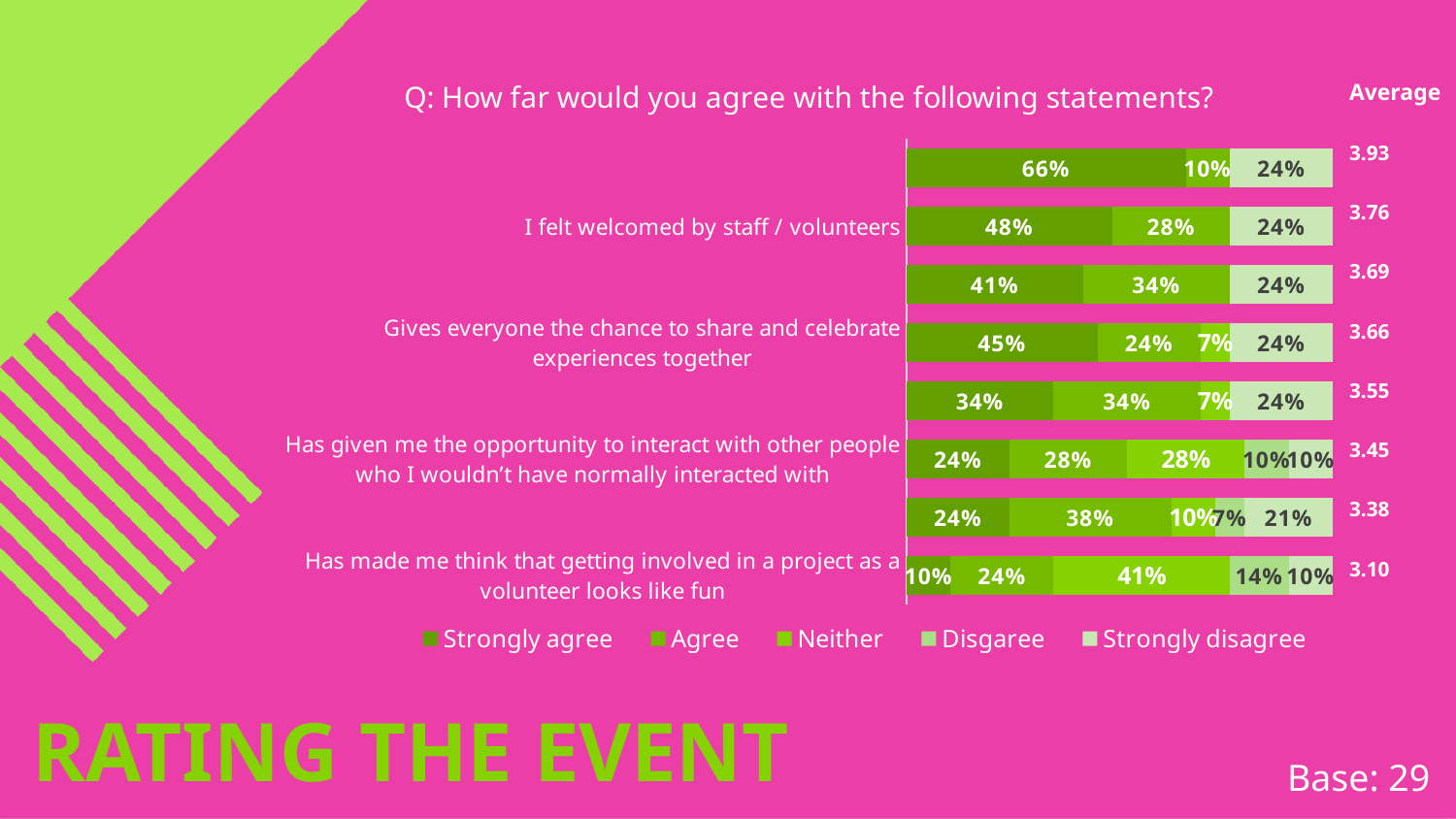
What is the average score for 'I felt welcomed by staff / volunteers'? 3.76 How many bars are plotted in the chart? 8 How many series does the legend list? 5 What is the difference in 'Strongly agree' share between 'I felt welcomed by staff / volunteers' and 'Has given me the opportunity to interact with other people who I wouldn't have normally interacted with'? 24 percentage points What percentage agreed with 'Gives everyone the chance to share and celebrate experiences together'? 24% Which statement has the larger 'Strongly agree' share: 'I felt welcomed by staff / volunteers' or 'Has given me the opportunity to interact with other people who I wouldn't have normally interacted with'? I felt welcomed by staff / volunteers What type of chart is shown on the slide? Stacked bar chart What is the highest average score shown in the Average column? 3.93 What percentage strongly disagreed with 'Has given me the opportunity to interact with other people who I wouldn't have normally interacted with'? 10% What is the average score for 'Has made me think that getting involved in a project as a volunteer looks like fun'? 3.10 What percentage strongly agreed with 'I felt welcomed by staff / volunteers'? 48% What percentage answered 'Neither' for 'Has made me think that getting involved in a project as a volunteer looks like fun'? 41%